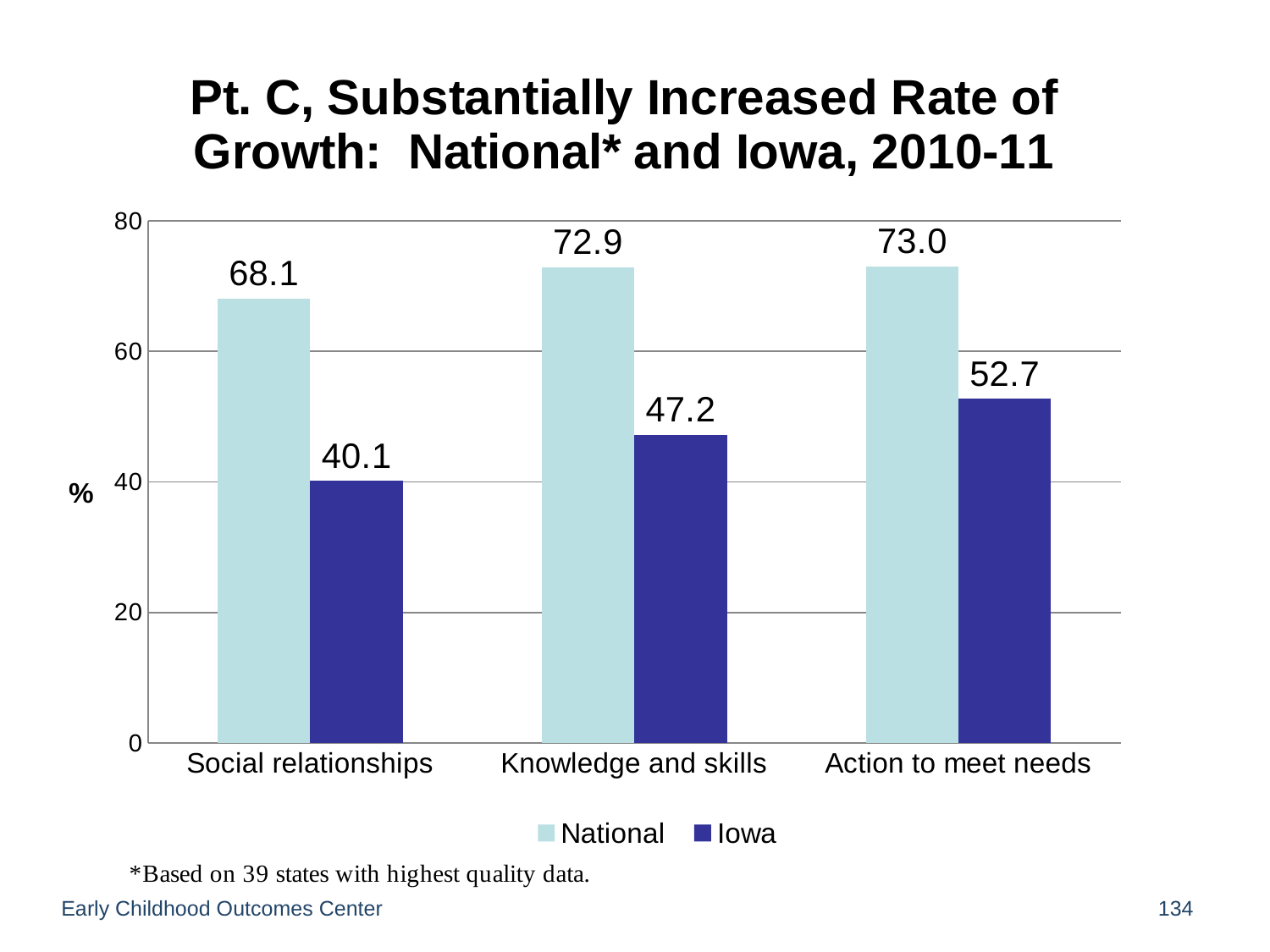
What is the difference between the National and Iowa values for Action to meet needs? 20.3 What is the difference between the National and Iowa values for Social relationships? 28.0 What is the Iowa value for Action to meet needs? 52.7 What kind of chart is shown on the slide? Bar chart Which category has the lowest National value? Social relationships How many categories are shown on the x axis? 3 What is the National value for Social relationships? 68.1 What is the Iowa value for Knowledge and skills? 47.2 Do the Iowa values rise or fall from Social relationships to Action to meet needs? Rise How many series does the legend list? 2 Which is larger for Knowledge and skills, the National value or the Iowa value? National Which category has the lowest Iowa value? Social relationships